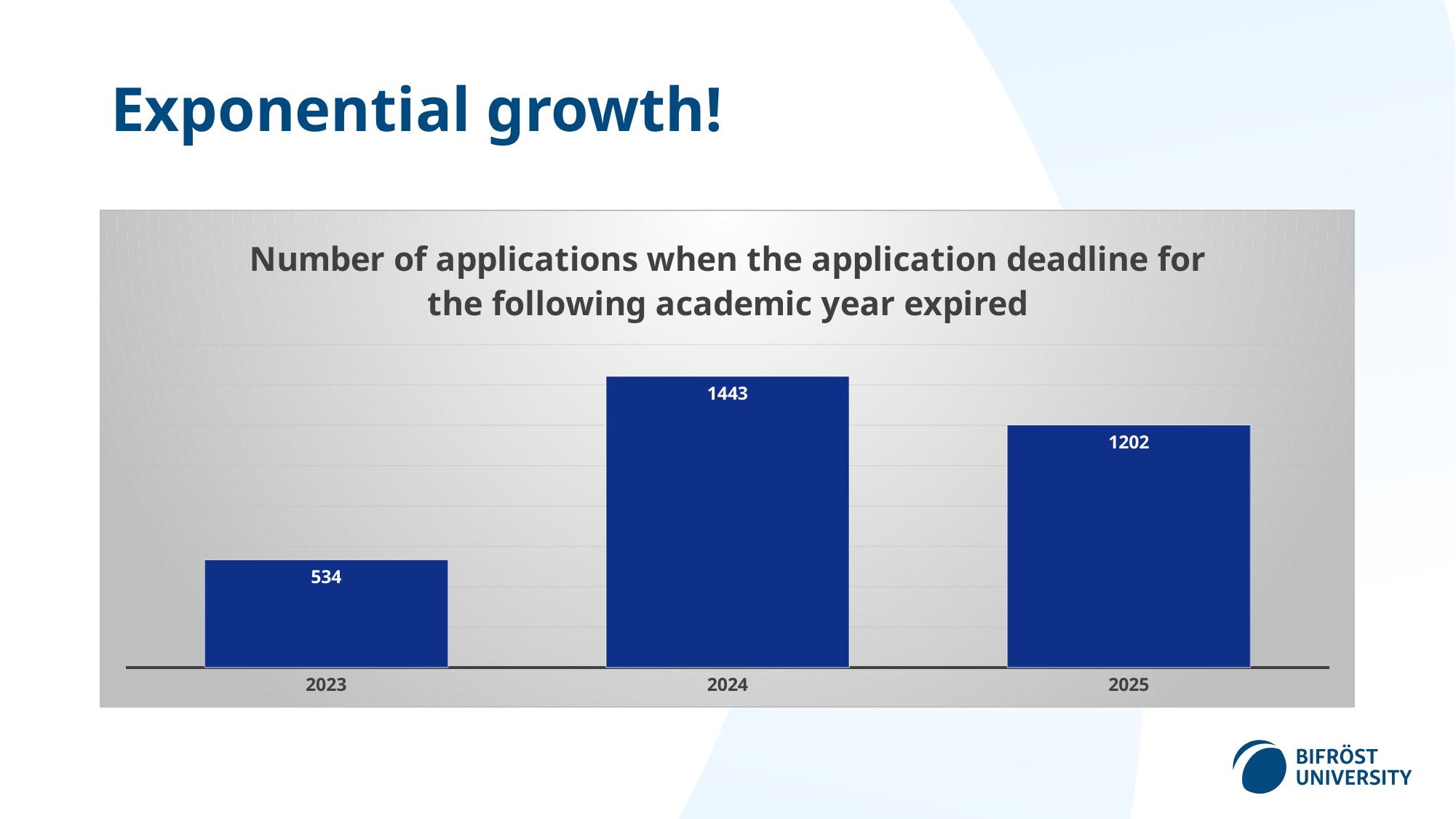
What is the difference in applications between 2024 and 2025? 241 Which year has the lowest number of applications? 2023 What is the number of applications for 2024? 1443 What is the number of applications for 2023? 534 Which year had more applications, 2025 or 2023? 2025 What is the difference in applications between 2024 and 2023? 909 How many years are shown in the chart? 3 Which year has the highest number of applications? 2024 What is the title of the chart? Number of applications when the application deadline for the following academic year expired What kind of chart is shown on the slide? Bar chart What is the number of applications for 2025? 1202 Did the number of applications rise or fall from 2024 to 2025? Fall